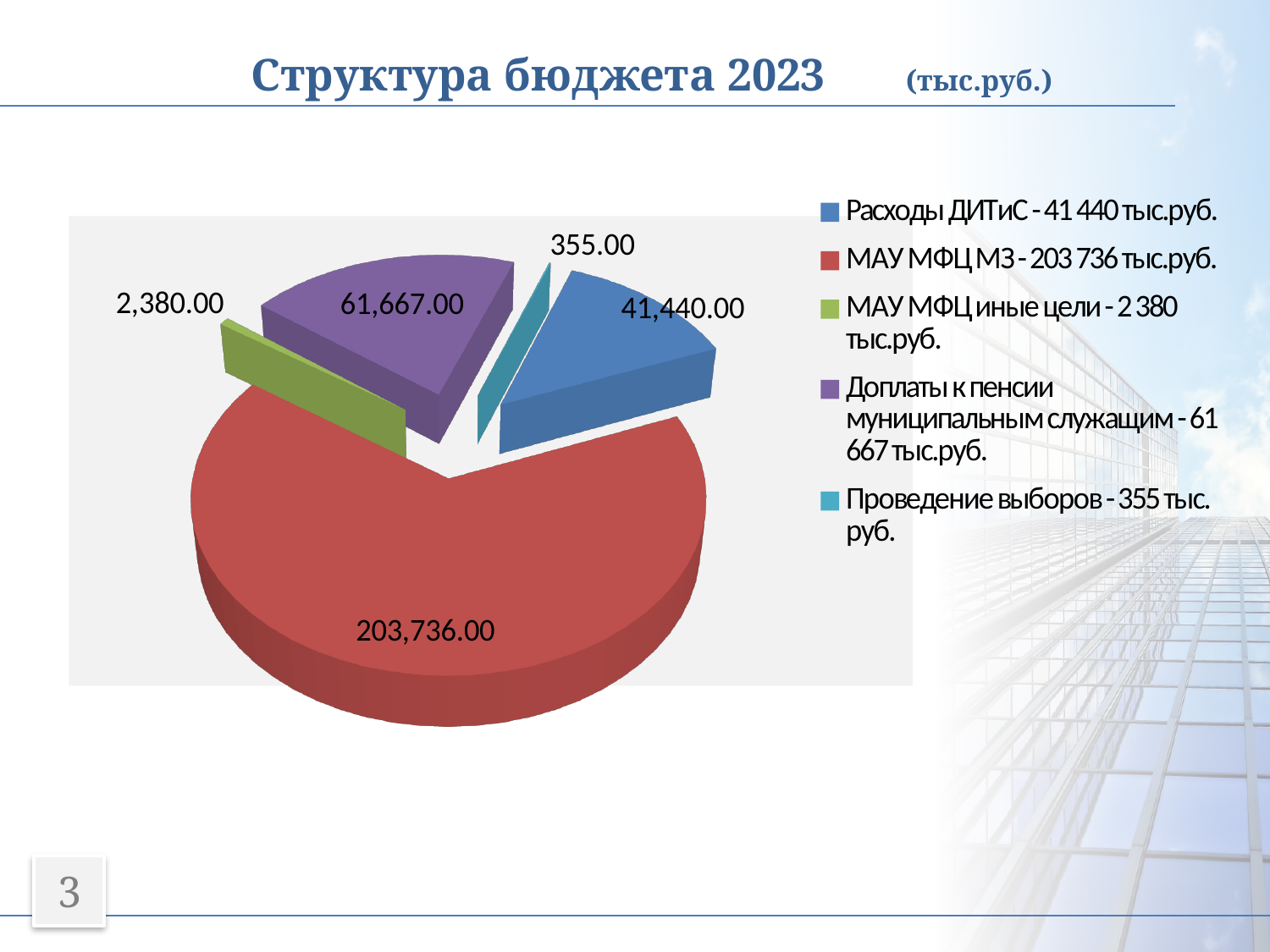
Which is larger, the value for Доплаты к пенсии муниципальным служащим or the value for Расходы ДИТиС? Доплаты к пенсии муниципальным служащим What is the difference between the values for МАУ МФЦ иные цели and Проведение выборов? 2,025.00 What colour is the slice for МАУ МФЦ иные цели? Green How many slices does the pie chart have? 5 What is the value for Доплаты к пенсии муниципальным служащим? 61,667.00 What is the value for МАУ МФЦ МЗ? 203,736.00 Which category has the largest slice of the pie? МАУ МФЦ МЗ What is the difference between the values for МАУ МФЦ МЗ and Расходы ДИТиС? 162,296.00 What kind of chart is shown on the slide? Pie chart Which category has the smallest slice of the pie? Проведение выборов What is the value for Проведение выборов? 355.00 What is the value for Расходы ДИТиС? 41,440.00